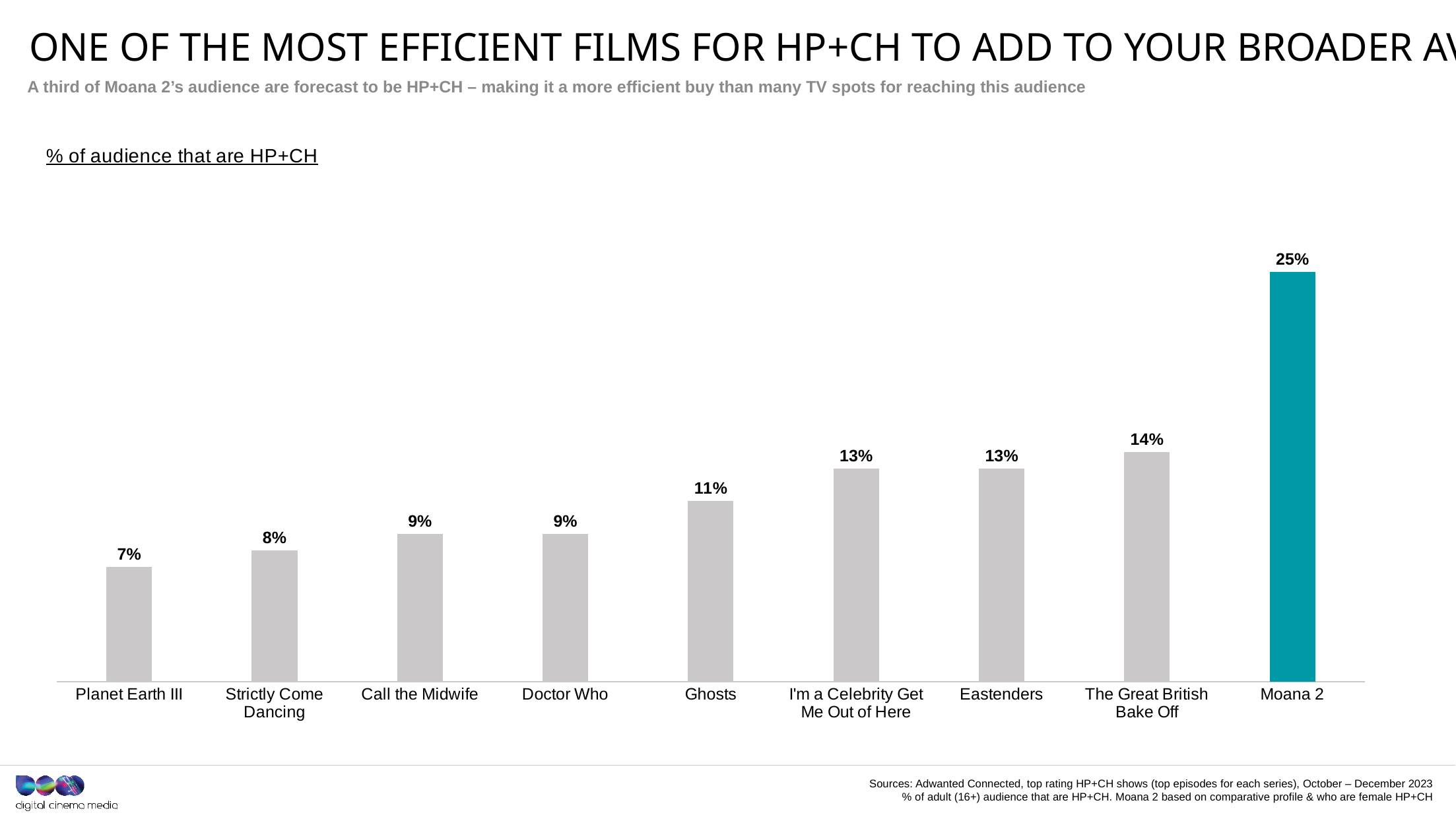
Do the values generally rise or fall from left to right along the x axis? Rise Which category has the lowest % of audience that are HP+CH? Planet Earth III How many categories are shown on the chart? 9 What kind of chart is shown on the slide? Bar chart Which category has the highest % of audience that are HP+CH? Moana 2 What is the difference between the values for Moana 2 and The Great British Bake Off? 11% What is the value for The Great British Bake Off? 14% What percentage of Moana 2's audience are HP+CH? 25% Which bar is coloured differently (teal) from the others? Moana 2 What is the value for Ghosts? 11% What is the difference between the values for Eastenders and Planet Earth III? 6% Which has a higher value, Ghosts or Strictly Come Dancing? Ghosts